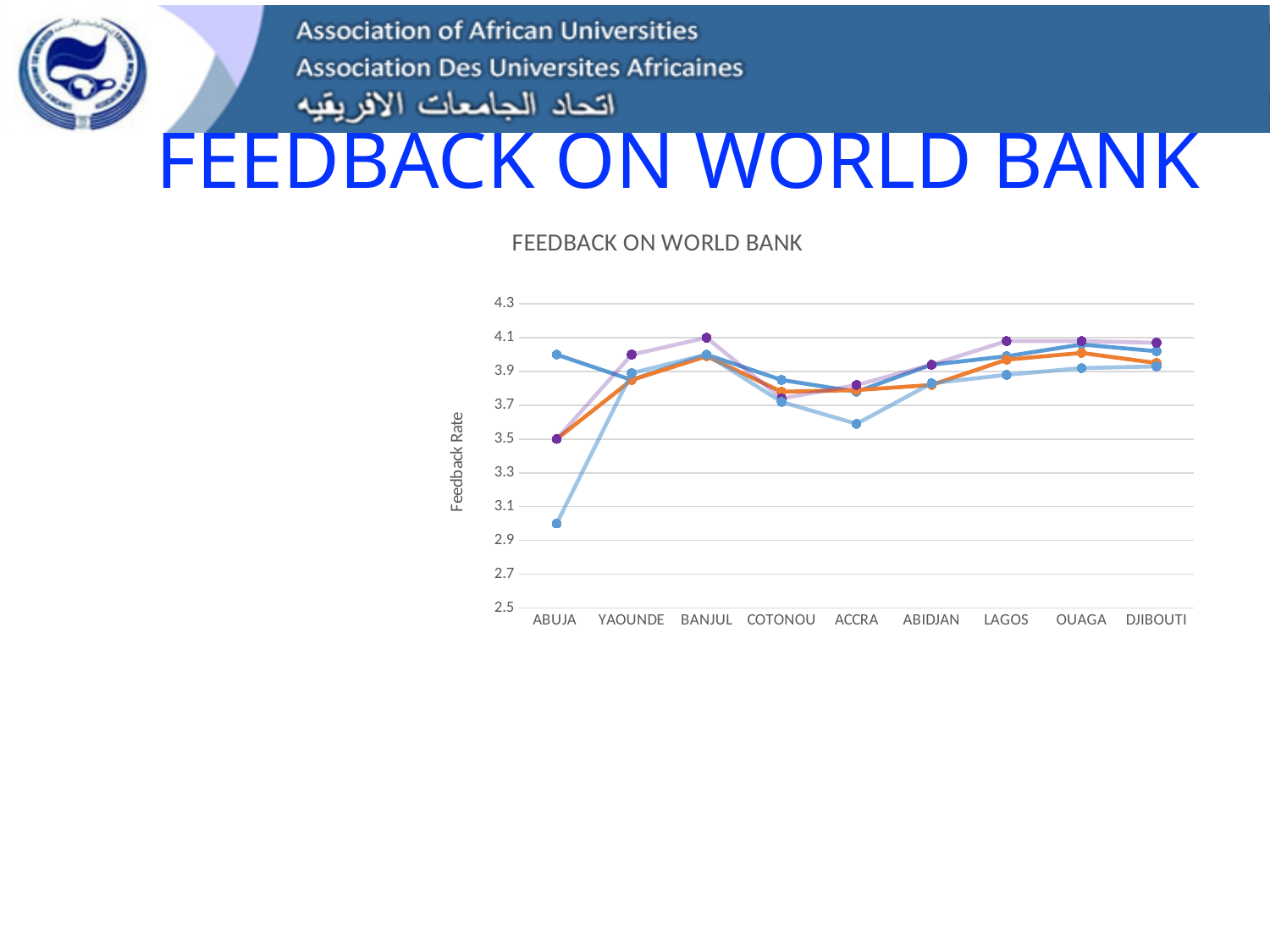
At ACCRA, which is higher: the purple line or the light blue line? the purple line What kind of chart is shown on the slide? line chart Does the light blue line rise or fall from ABUJA to YAOUNDE? rise What is the label on the vertical axis of the chart? Feedback Rate Is the value of the purple line at LAGOS greater or less than 3.9? greater Does the purple line rise or fall from BANJUL to COTONOU? fall How many cities are listed along the x axis of the chart? 9 Is the value of the purple line at BANJUL greater or less than 3.9? greater Is the value of the light blue line at ACCRA greater or less than 3.7? less Which city has the lowest point plotted on the chart? ABUJA What is the title of the chart? FEEDBACK ON WORLD BANK